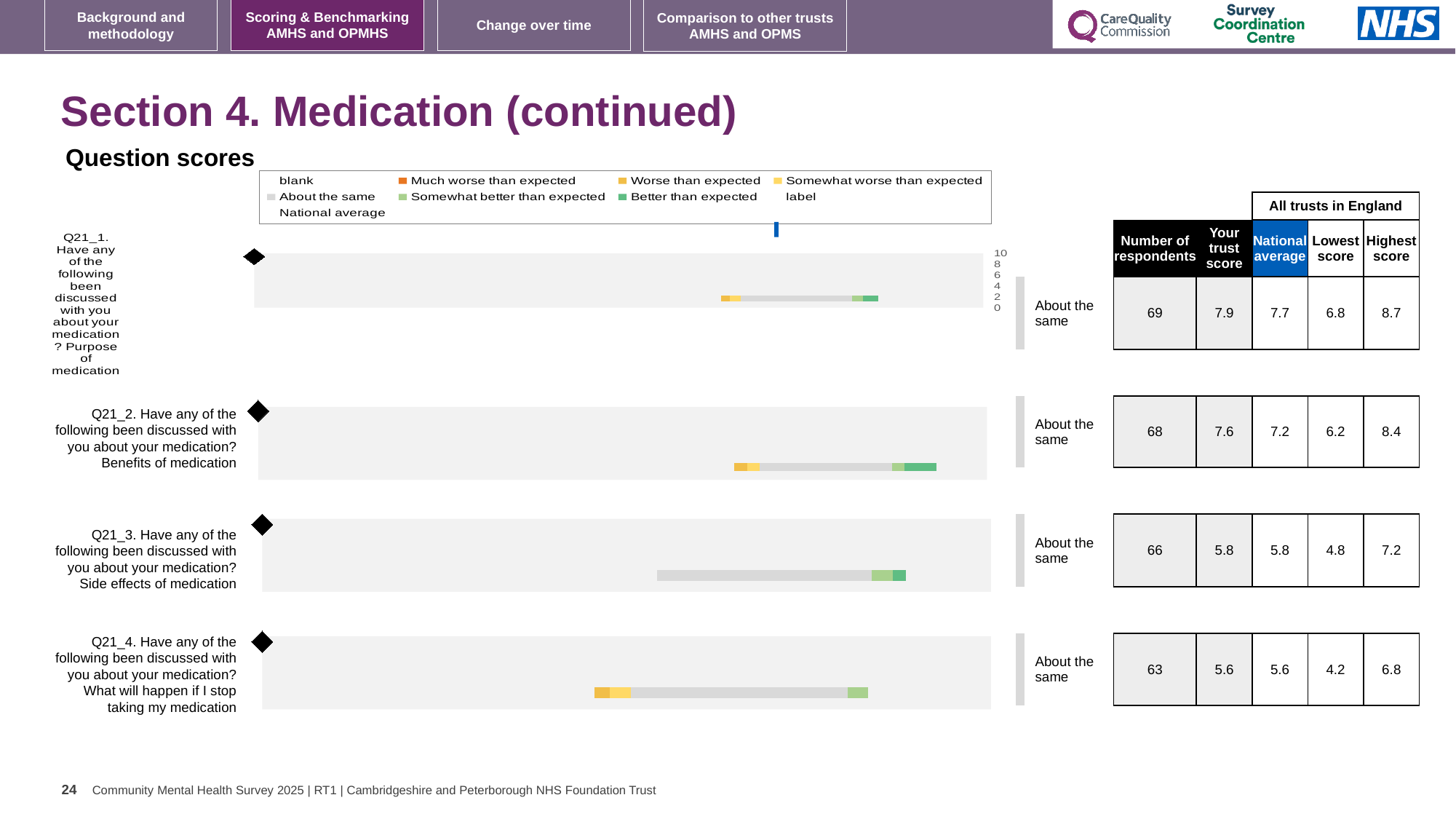
What rating label is shown next to the chart for Q21_4 (What will happen if I stop taking my medication)? About the same What is the national average for Q21_3 (Side effects of medication) shown alongside its chart? 5.8 What is the trust score for Q21_2 (Benefits of medication) shown alongside its chart? 7.6 How many question score charts (Q21_1 to Q21_4) are shown on the slide? 4 What rating label is shown next to the chart for Q21_1 (Purpose of medication)? About the same Which question has the highest trust score among Q21_1 to Q21_4? Q21_1. Purpose of medication Which legend entry is shown in orange in the question score charts? Much worse than expected Which question has the lowest trust score among Q21_1 to Q21_4? Q21_4. What will happen if I stop taking my medication Which legend entry is shown in dark green in the question score charts? Better than expected How many entries does the legend above the question score charts list? 9 What kind of chart is used to show the question scores on this slide? bar chart What is the difference between the highest score and the lowest score for Q21_1 (Purpose of medication)? 1.9